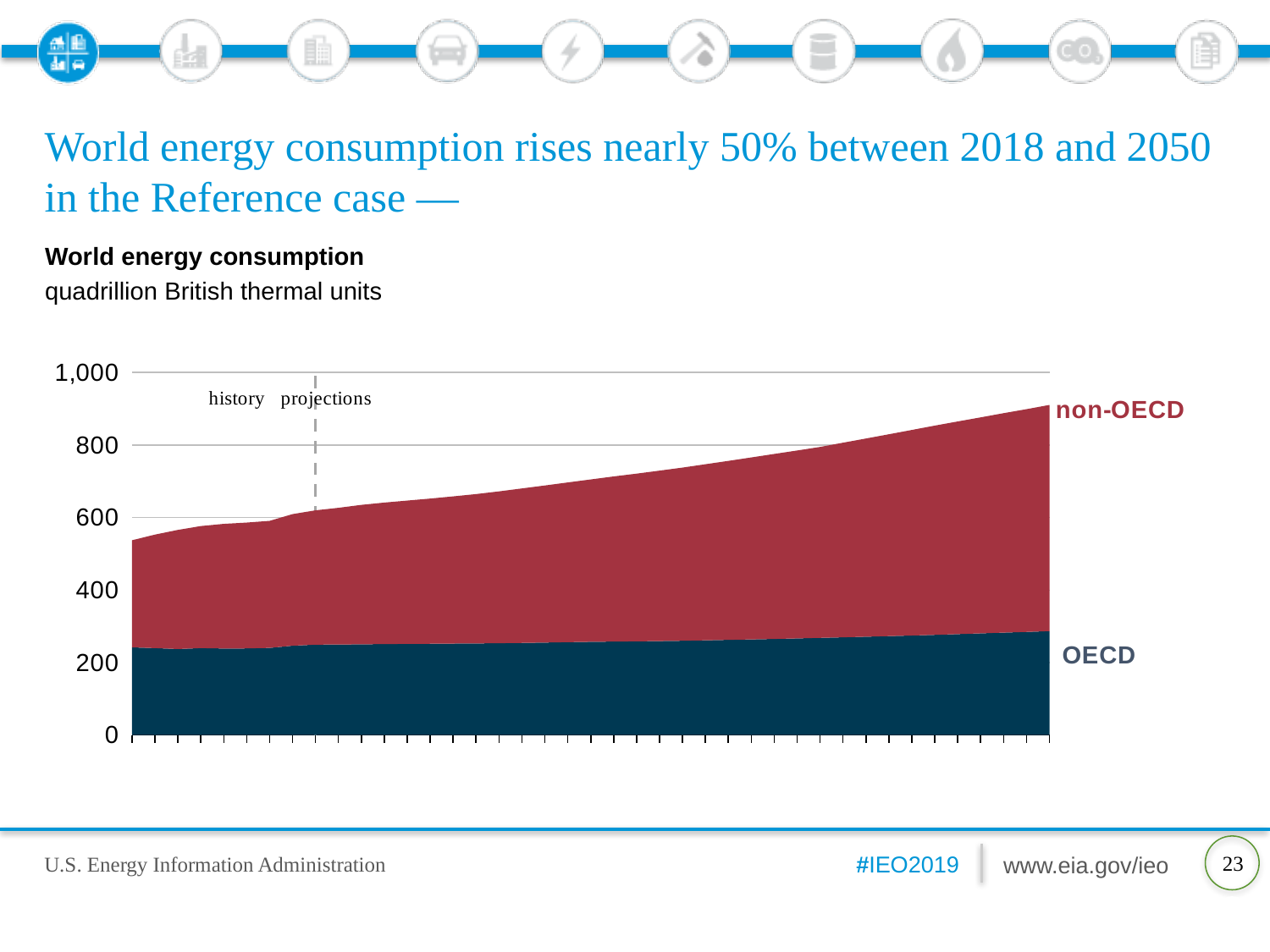
What kind of chart is shown on the slide? stacked area chart What are the two series shown in the chart? non-OECD and OECD Is the total world energy consumption at the right edge of the chart greater or less than 800? greater Does the OECD series rise or fall from left to right across the chart? rise Is the total world energy consumption at the left edge of the chart greater or less than 600? less Is the total world energy consumption at the right edge of the chart greater or less than 1,000? less What unit is the World energy consumption chart measured in? quadrillion British thermal units Which series accounts for the larger share of world energy consumption at the right edge of the chart, OECD or non-OECD? non-OECD Which series is plotted at the bottom of the stacked area chart? OECD Does total world energy consumption rise or fall from left to right across the chart? rise How many series are plotted in the World energy consumption chart? 2